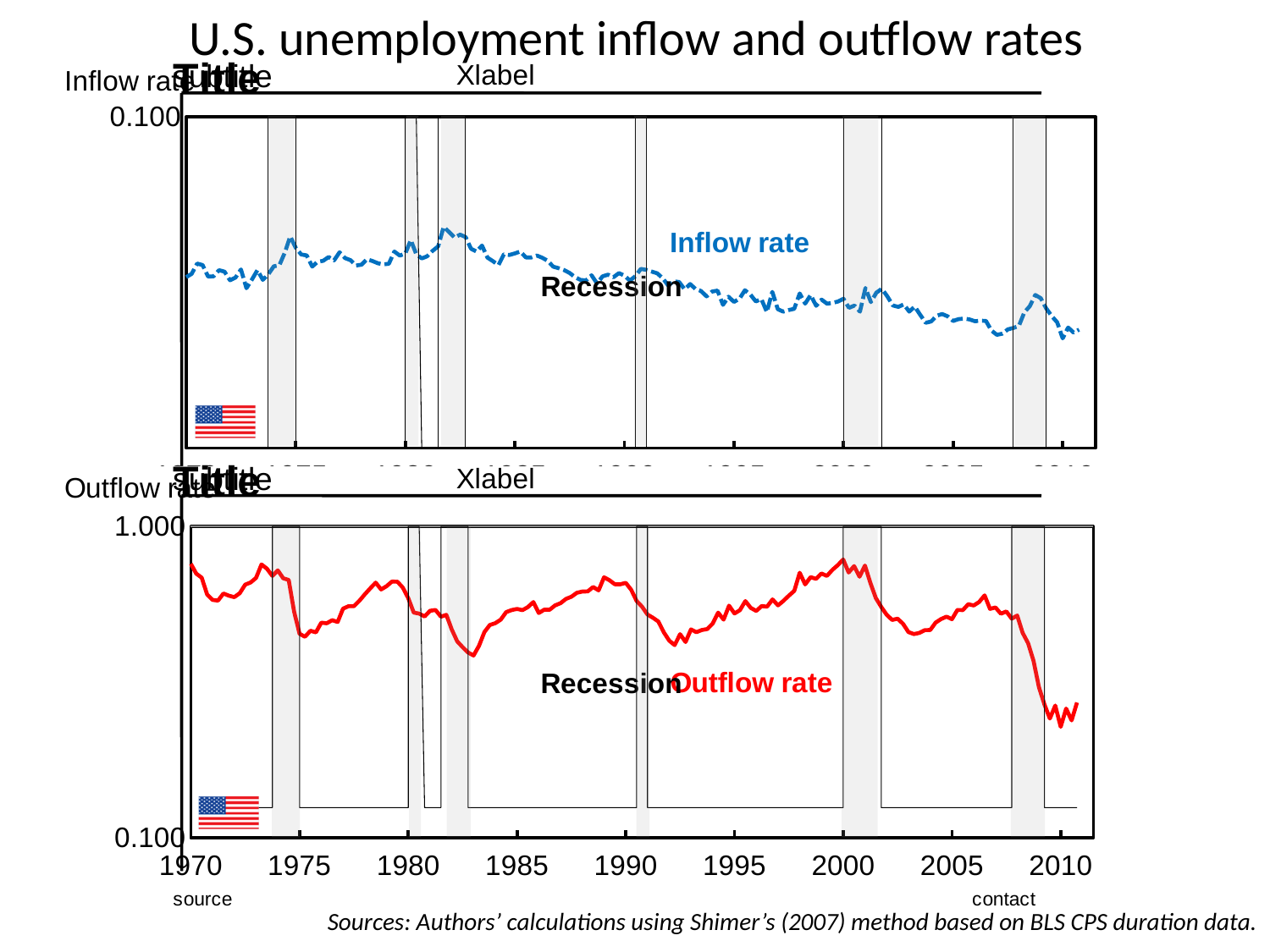
In the bottom chart, what colour is the outflow rate line? red What kind of chart is used to show the inflow and outflow rates? line chart What is the title of the slide's chart? U.S. unemployment inflow and outflow rates In the bottom chart, is the outflow rate in 2000 greater or less than 0.100? greater In the bottom chart, does the outflow rate rise or fall between 1992 and 2000? rise In the bottom chart, does the outflow rate rise or fall between 2007 and 2010? fall What is the first year shown on the x axis of the bottom chart? 1970 In the bottom chart, is the outflow rate in 2010 greater or less than 1.000? less In the top chart, is the inflow rate in 1985 greater or less than 0.100? less In the top chart, does the inflow rate generally rise or fall between 1985 and 2007? fall In the top chart, what colour is the inflow rate line? blue